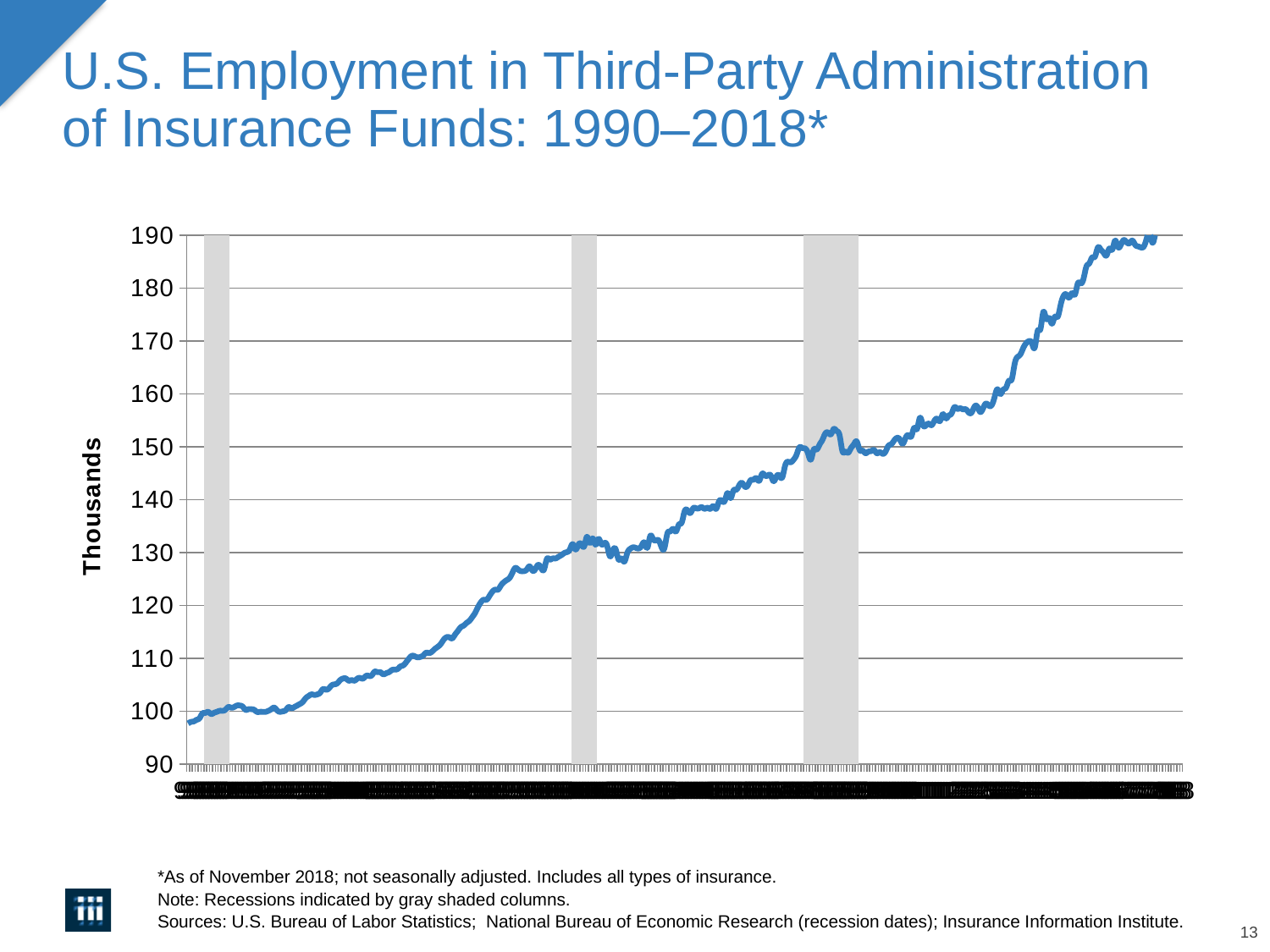
What kind of chart is shown on the slide? line chart Is the value of the line during the third gray shaded recession column greater or less than 140? greater Is the peak reached just before the second gray shaded recession column greater or less than 140? less Is the value at the left end of the line (the start of the series) greater or less than 110? less Where along the series does the line reach its highest value: at the start, in the middle, or at the end? at the end How many gray shaded recession columns are shown on the chart? 3 Where along the series does the line reach its lowest value: at the start, in the middle, or at the end? at the start Overall, do the values rise or fall from left to right along the x axis? rise What is the title of the chart? U.S. Employment in Third-Party Administration of Insurance Funds: 1990–2018* What is the label on the vertical axis? Thousands